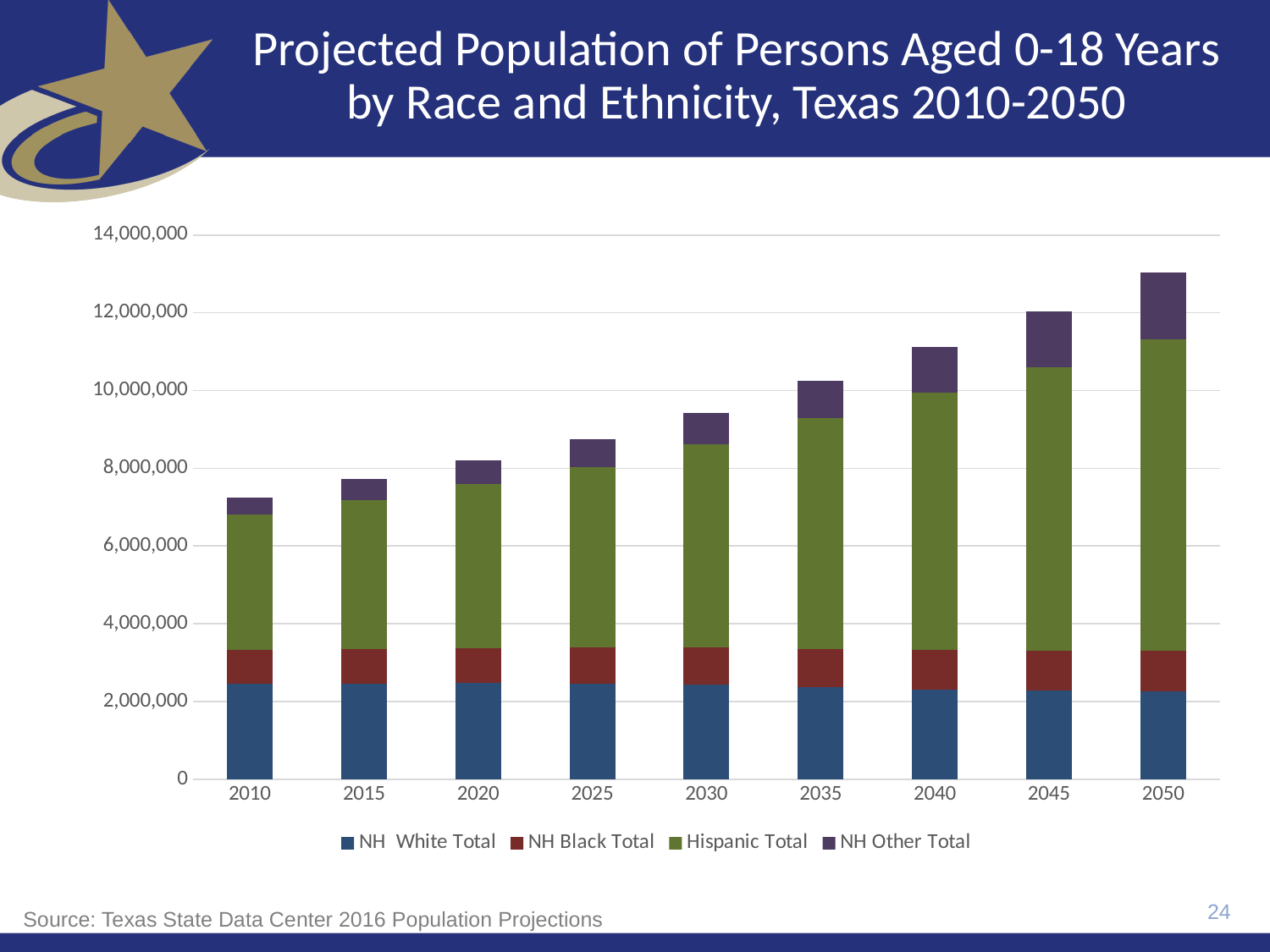
Which year has the tallest stacked bar (largest total projected population)? 2050 Which series is shown in green in the chart's legend? Hispanic Total In 2050, which segment is larger: Hispanic Total or NH White Total? Hispanic Total What kind of chart is shown on the slide? stacked bar chart Is the total projected population for 2025 greater or less than 10,000,000? less How many years are shown along the x axis of the chart? 9 Is the total projected population for 2040 greater or less than 10,000,000? greater Which year has the shortest stacked bar (smallest total projected population)? 2010 How many series does the chart's legend list? 4 Do the total projected populations rise or fall from 2010 to 2050? rise Is the total projected population for 2010 greater or less than 8,000,000? less